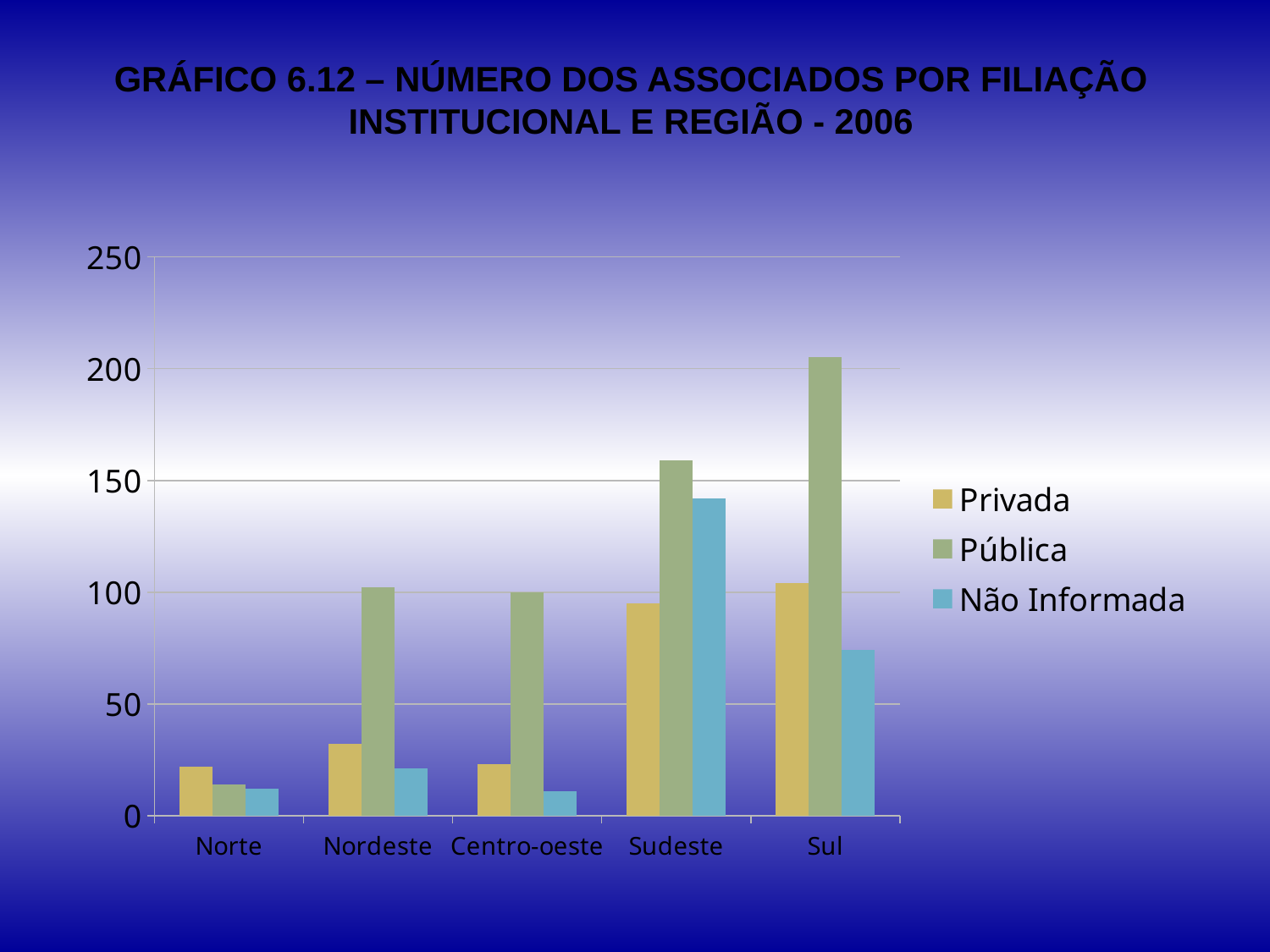
How many series does the legend list? 3 Is the value for Não Informada in Sul greater or less than 50? greater Which region has the lowest value for Pública? Norte Is the value for Privada in Norte greater or less than 50? less Which is larger: the Pública value for Sudeste or the Pública value for Sul? Sul What kind of chart is shown on the slide? bar chart Which region has the highest value for Não Informada? Sudeste How many regions are shown on the x axis? 5 Which region has the highest value for Pública? Sul Which is larger: the Não Informada value for Sudeste or the Não Informada value for Sul? Sudeste Is the value for Pública in Sudeste greater or less than 150? greater Which series is shown in green in the legend? Pública